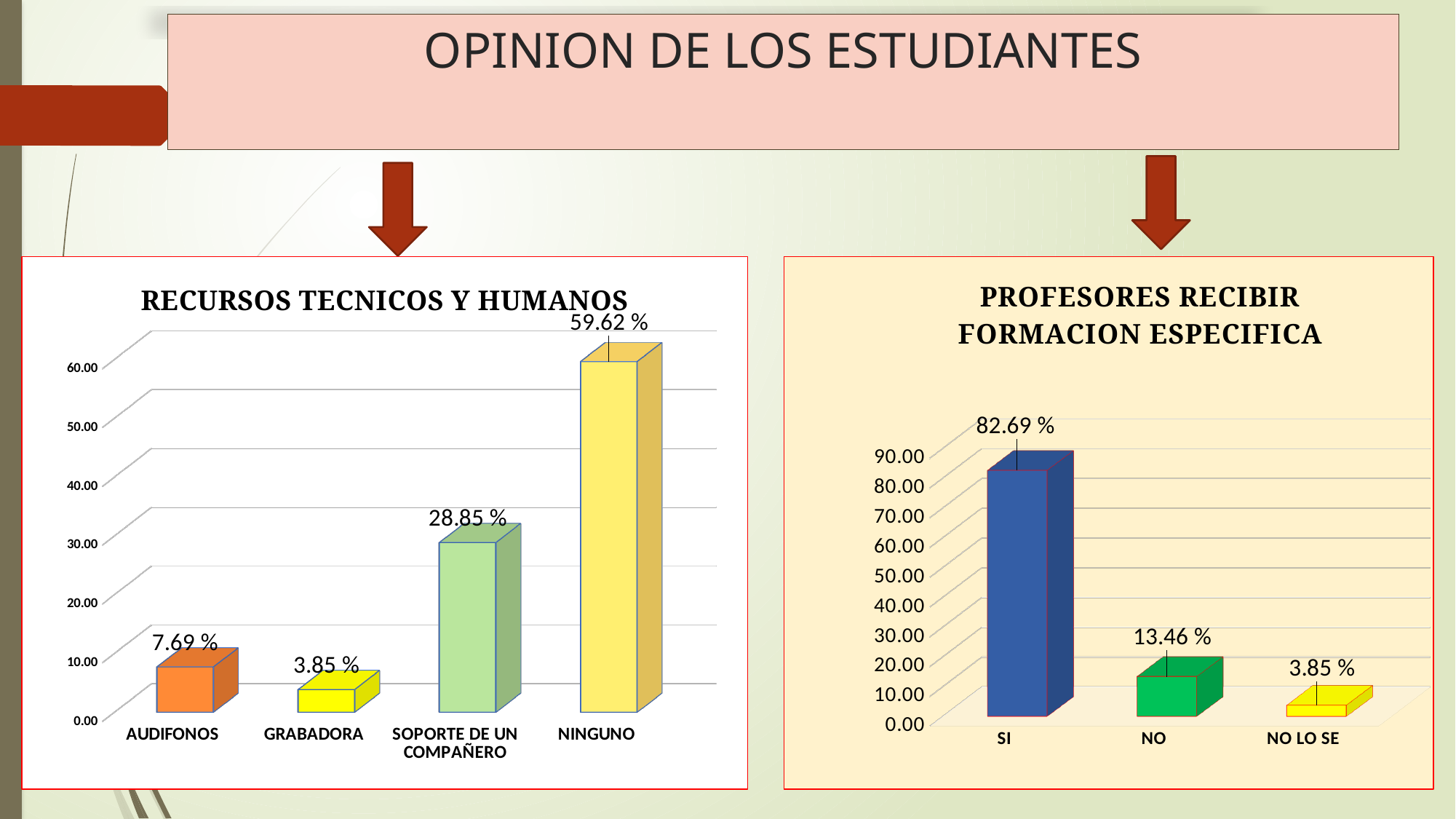
In the 'PROFESORES RECIBIR FORMACION ESPECIFICA' chart, what is the value for SI? 82.69 % In the 'RECURSOS TECNICOS Y HUMANOS' chart, which category has the lowest value? GRABADORA In the 'PROFESORES RECIBIR FORMACION ESPECIFICA' chart, what is the value for NO LO SE? 3.85 % In the 'RECURSOS TECNICOS Y HUMANOS' chart, which is larger, AUDIFONOS or GRABADORA? AUDIFONOS In the 'RECURSOS TECNICOS Y HUMANOS' chart, what is the value for NINGUNO? 59.62 % In the 'RECURSOS TECNICOS Y HUMANOS' chart, how many categories are shown? 4 What kind of chart is the 'PROFESORES RECIBIR FORMACION ESPECIFICA' chart? Bar chart In the 'RECURSOS TECNICOS Y HUMANOS' chart, what is the value for SOPORTE DE UN COMPAÑERO? 28.85 % In the 'PROFESORES RECIBIR FORMACION ESPECIFICA' chart, what colour is the bar for SI? Blue In the 'PROFESORES RECIBIR FORMACION ESPECIFICA' chart, which category has the highest value? SI In the 'PROFESORES RECIBIR FORMACION ESPECIFICA' chart, what is the difference between SI and NO? 69.23 % In the 'RECURSOS TECNICOS Y HUMANOS' chart, what is the difference between NINGUNO and SOPORTE DE UN COMPAÑERO? 30.77 %